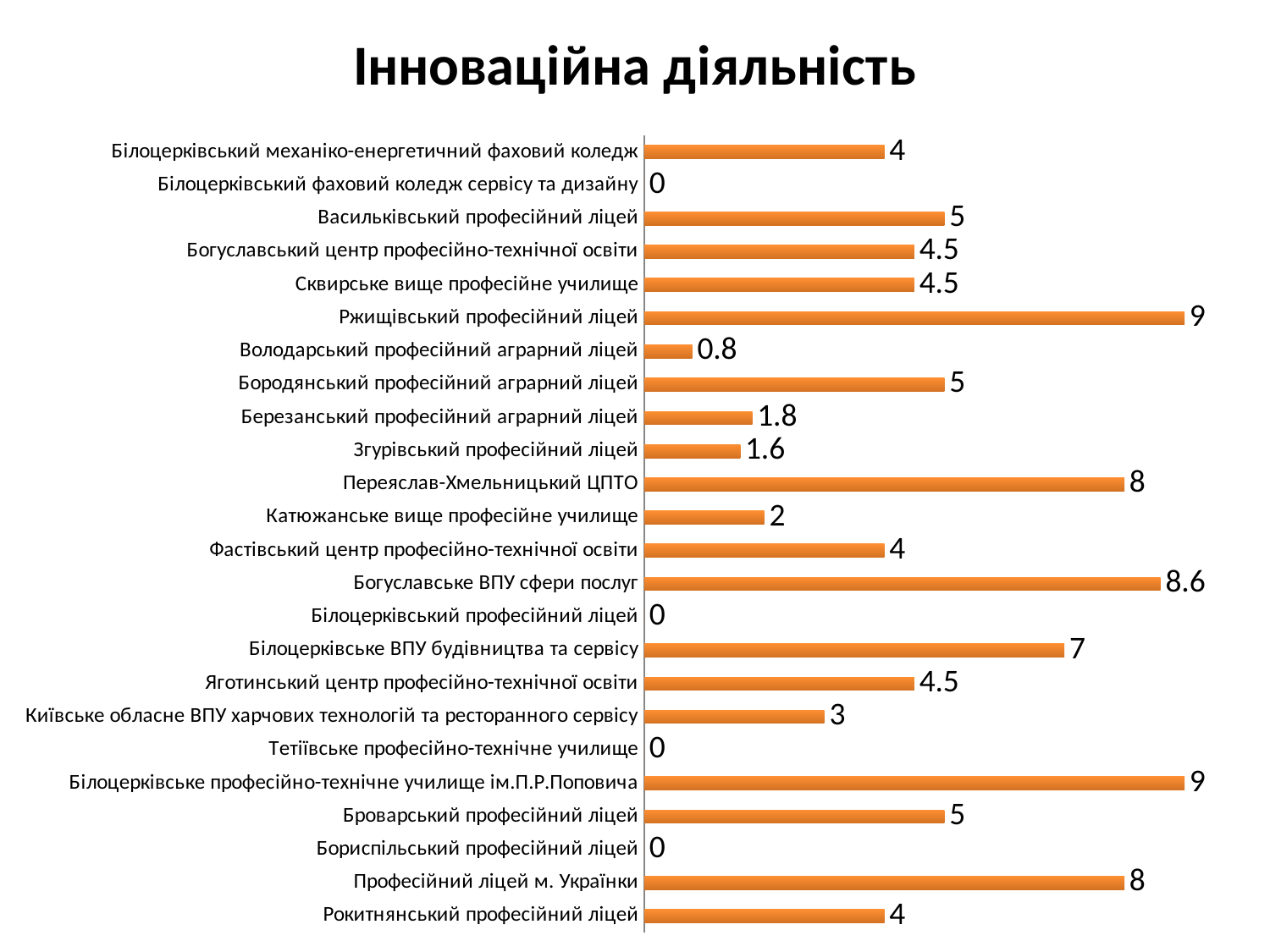
What is the value for Богуславське ВПУ сфери послуг? 8.6 What is the value for Володарський професійний аграрний ліцей? 0.8 How many categories have a value of 0? 4 Which has a larger value, Переяслав-Хмельницький ЦПТО or Фастівський центр професійно-технічної освіти? Переяслав-Хмельницький ЦПТО What is the difference between the values for Білоцерківське ВПУ будівництва та сервісу and Катюжанське вище професійне училище? 5 What is the difference between the values for Березанський професійний аграрний ліцей and Згурівський професійний ліцей? 0.2 How many categories are shown in the chart? 24 What is the value for Ржищівський професійний ліцей? 9 What is the highest value shown in the chart? 9 What is the title of the chart? Інноваційна діяльність What type of chart is shown on the slide? bar chart What is the value for Київське обласне ВПУ харчових технологій та ресторанного сервісу? 3